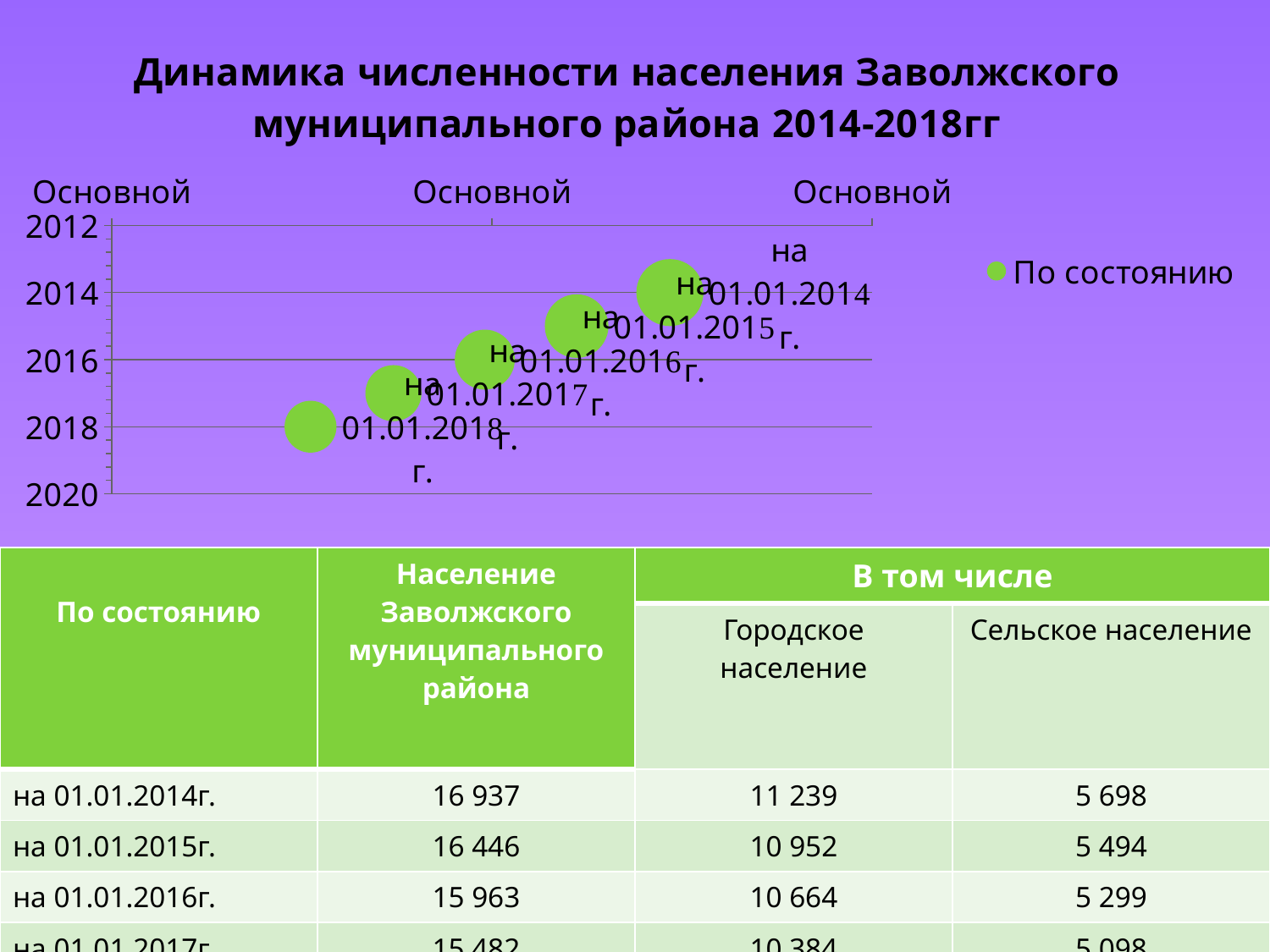
How many bubbles (data points) are plotted on the chart? 5 Which bubble is positioned furthest to the left on the chart? на 01.01.2018 г. Which bubble is positioned furthest to the right on the chart, 'на 01.01.2014 г.' or 'на 01.01.2018 г.'? на 01.01.2014 г. What is the title of the chart on the slide? Динамика численности населения Заволжского муниципального района 2014-2018гг Which bubble is plotted lowest on the chart (closest to the 2018 tick)? на 01.01.2018 г. How many series does the chart legend list? 1 What kind of chart is shown on the slide? bubble chart What is the legend entry of the chart? По состоянию What are the first and last tick labels on the vertical axis of the chart? 2012 and 2020 As the date moves from 01.01.2014 to 01.01.2018, do the bubbles move to the right or to the left along the horizontal axis? to the left